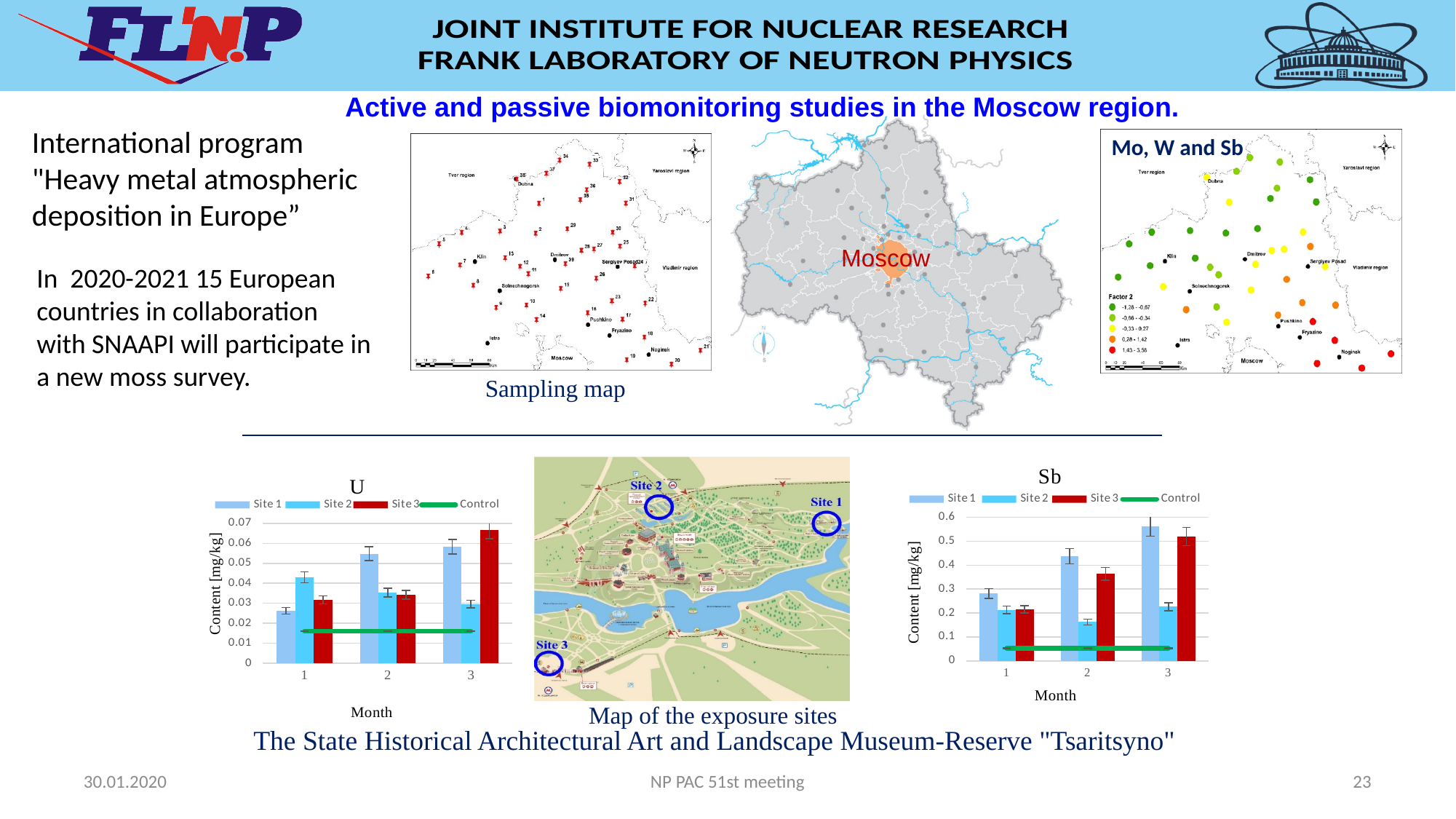
In the chart titled "Sb", is the value for Site 1 in month 3 greater or less than 0.5? greater In the chart titled "U", is the value for Site 1 in month 1 greater or less than 0.03? less In the chart titled "Sb", which site has the lowest value in month 3? Site 2 In the chart titled "U", do the Site 2 values rise or fall from month 1 to month 3? fall In the chart titled "U", how many series does the legend list? 4 What kind of chart is the chart titled "U"? bar chart In the chart titled "Sb", what is the label of the y axis? Content [mg/kg] In the chart titled "Sb", is the value for Site 2 in month 2 greater or less than 0.2? less In the chart titled "Sb", do the Site 1 values rise or fall from month 1 to month 3? rise In the chart titled "U", do the Site 1 values rise or fall from month 1 to month 3? rise In the chart titled "U", which site has the highest value in month 3? Site 3